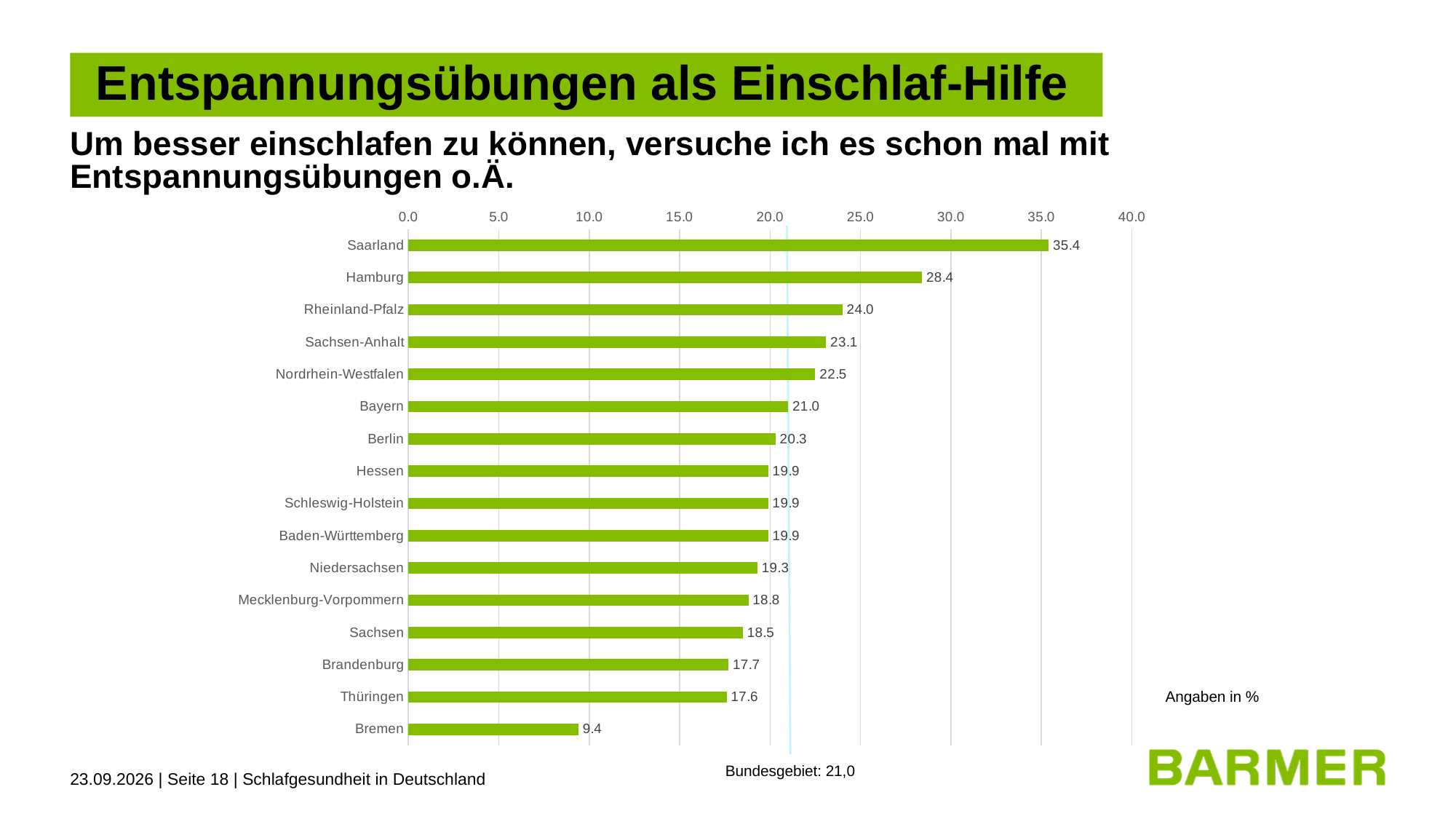
Which federal state has the highest value? Saarland What is the value for Bremen? 9.4 What is the difference between the values for Bayern and Bremen? 11.6 How many federal states are shown in the chart? 16 What is the value for Nordrhein-Westfalen? 22.5 What is the value for Saarland? 35.4 What kind of chart is shown on the slide? bar chart What is the value for the Bundesgebiet (national average) noted below the chart? 21,0 Which is larger, the value for Rheinland-Pfalz or the value for Sachsen? Rheinland-Pfalz Is the value for Hamburg greater or less than 25.0? greater Which federal state has the lowest value? Bremen What is the difference between the values for Saarland and Hamburg? 7.0